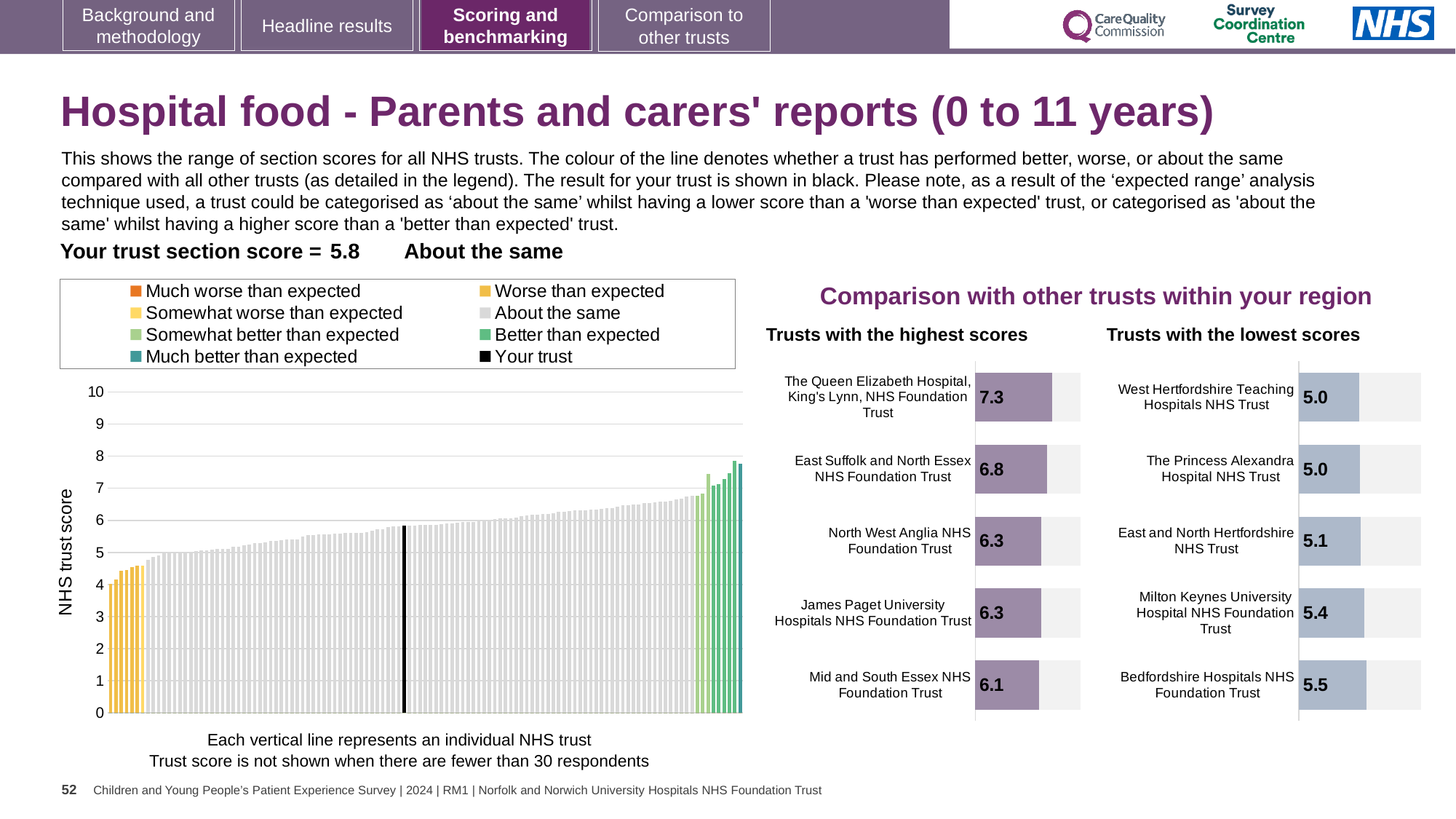
What is the section score for your trust (the black bar in the large chart on the left)? 5.8 How many entries does the legend above the large chart on the left list? 8 In the 'Trusts with the highest scores' chart, which trust has the highest score? The Queen Elizabeth Hospital, King's Lynn, NHS Foundation Trust In the 'Trusts with the highest scores' chart, what is the score for East Suffolk and North Essex NHS Foundation Trust? 6.8 In the 'Trusts with the highest scores' chart, what is the difference between the scores of The Queen Elizabeth Hospital, King's Lynn, NHS Foundation Trust and Mid and South Essex NHS Foundation Trust? 1.2 In the 'Trusts with the lowest scores' chart, which trust has the highest score? Bedfordshire Hospitals NHS Foundation Trust In the large chart on the left, what is the label on the vertical axis? NHS trust score In the large chart on the left, is the value of the tallest bar greater or less than 7? greater In the large chart on the left, do the bar heights rise or fall from left to right? rise What kind of chart is the large chart on the left showing NHS trust scores? bar chart How many trusts are shown in the 'Trusts with the lowest scores' chart? 5 In the 'Trusts with the lowest scores' chart, what is the score for Milton Keynes University Hospital NHS Foundation Trust? 5.4